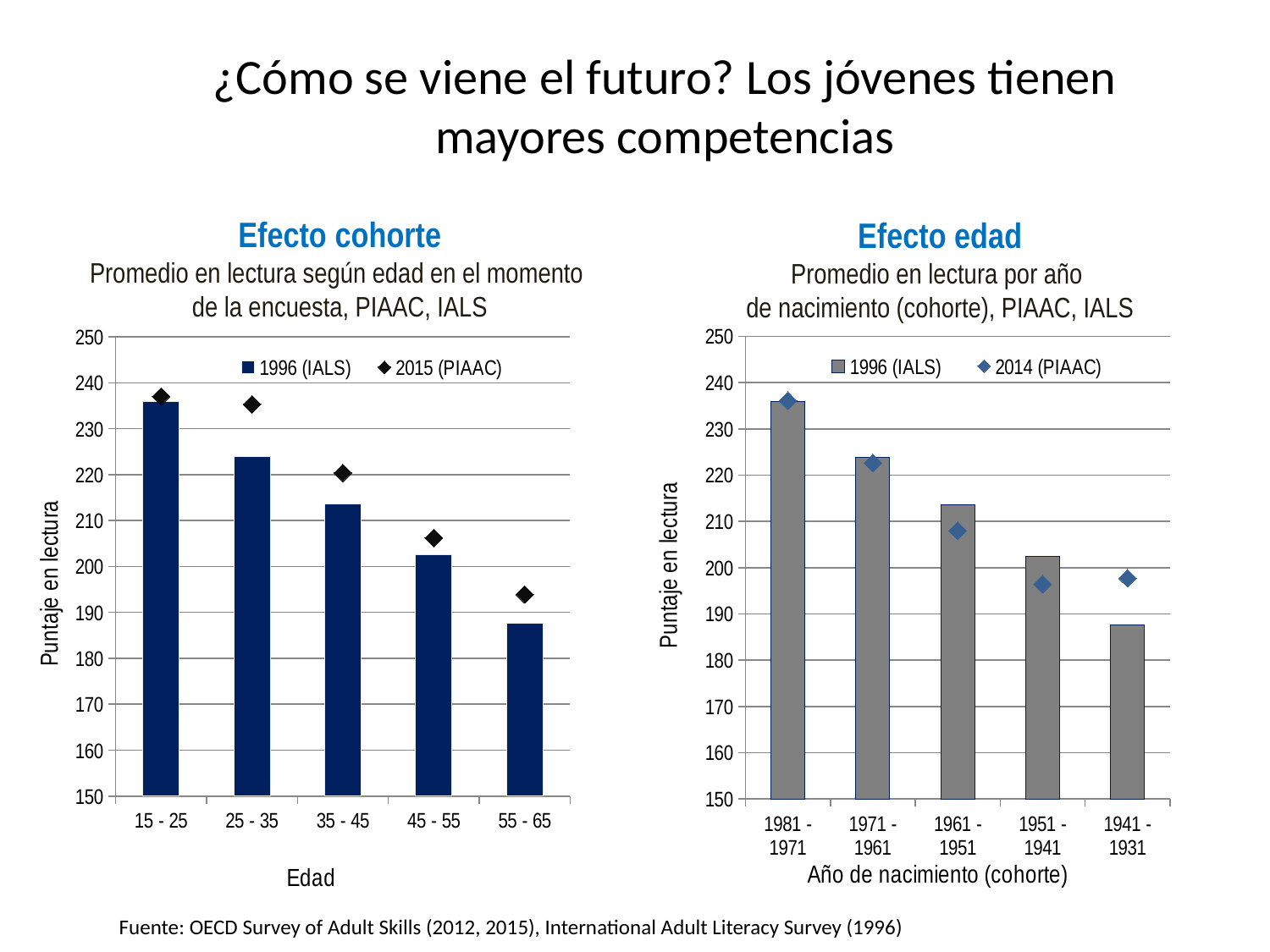
On the 'Efecto edad' chart, which cohort has the lowest 1996 (IALS) value? 1941 - 1931 On the 'Efecto cohorte' chart, how many series does the legend list? 2 On the 'Efecto cohorte' chart, what kind of chart is used to show the 1996 (IALS) series? bar chart On the 'Efecto edad' chart, is the 2014 (PIAAC) value for the 1951 - 1941 cohort greater or less than 200? less On the 'Efecto edad' chart, what are the two series listed in the legend? 1996 (IALS) and 2014 (PIAAC) On the 'Efecto cohorte' chart, how many age groups are shown on the x axis? 5 On the 'Efecto cohorte' chart, which age group has the highest 1996 (IALS) value? 15 - 25 On the 'Efecto cohorte' chart, which age group has the lowest 1996 (IALS) value? 55 - 65 On the 'Efecto edad' chart, how many birth cohorts are shown on the x axis? 5 On the 'Efecto cohorte' chart, do the 1996 (IALS) values rise or fall as age increases along the x axis? fall On the 'Efecto cohorte' chart, is the 1996 (IALS) value for 55 - 65 greater or less than 190? less On the 'Efecto cohorte' chart, for the 25 - 35 age group, which is larger: the 1996 (IALS) value or the 2015 (PIAAC) value? 2015 (PIAAC)